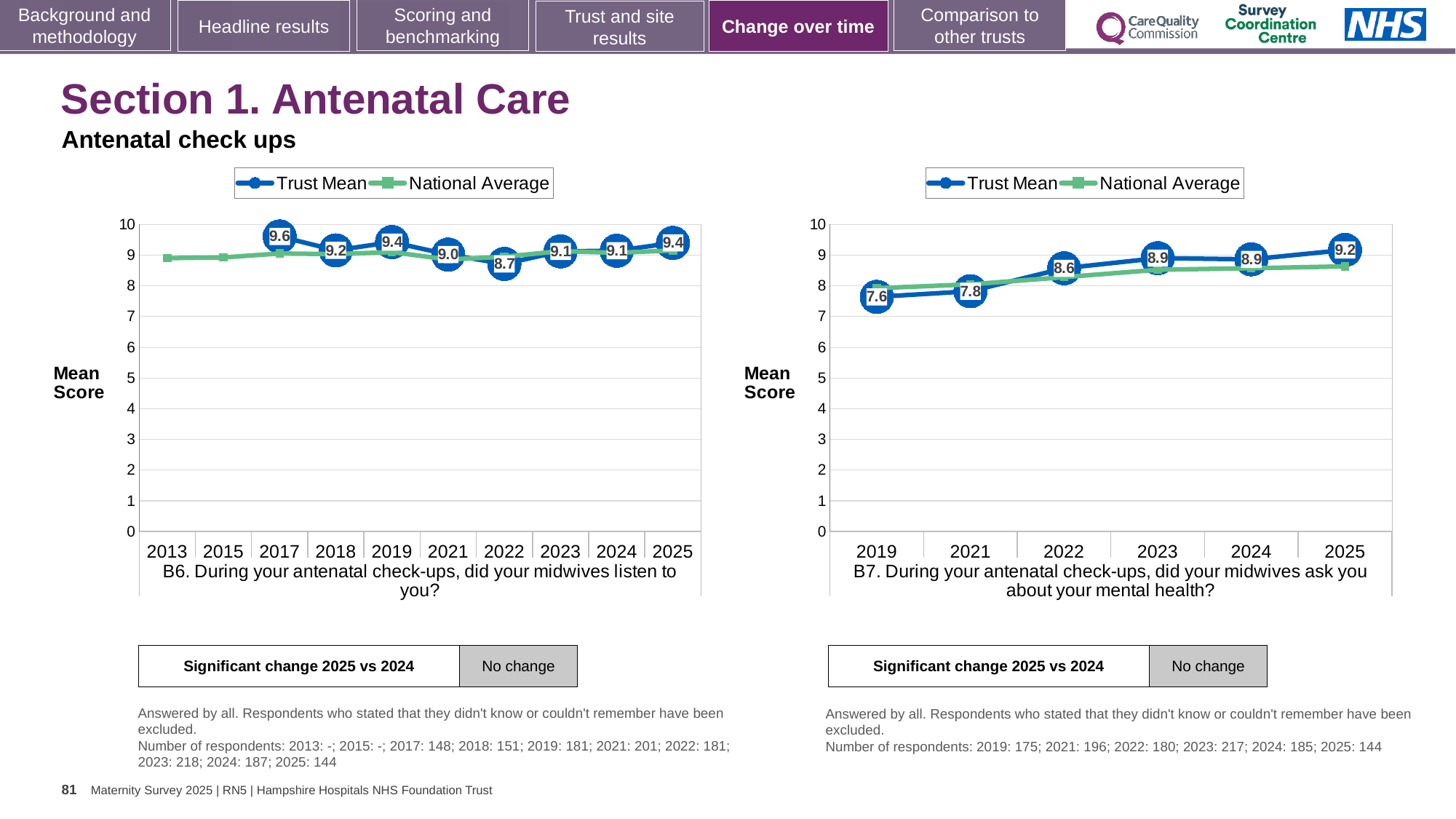
In the right chart (B7), does the Trust Mean score generally rise or fall from 2019 to 2025? rise In the right chart (B7), what is the difference between the Trust Mean scores for 2025 and 2019? 1.6 In the left chart (B6), what is the Trust Mean score for 2022? 8.7 How many years are shown on the x axis of the left chart (B6)? 10 In the left chart (B6), which year has the highest Trust Mean score? 2017 In the left chart (B6), which is larger, the Trust Mean score for 2018 or for 2019? 2019 In the left chart (B6), which year has the lowest Trust Mean score? 2022 In the right chart (B7), is the National Average value for 2019 greater or less than 9? less How many series does the legend of the left chart (B6) list? 2 In the right chart (B7), what is the Trust Mean score for 2019? 7.6 In the left chart (B6), what is the difference between the Trust Mean scores for 2017 and 2022? 0.9 In the right chart (B7), which year has the highest Trust Mean score? 2025